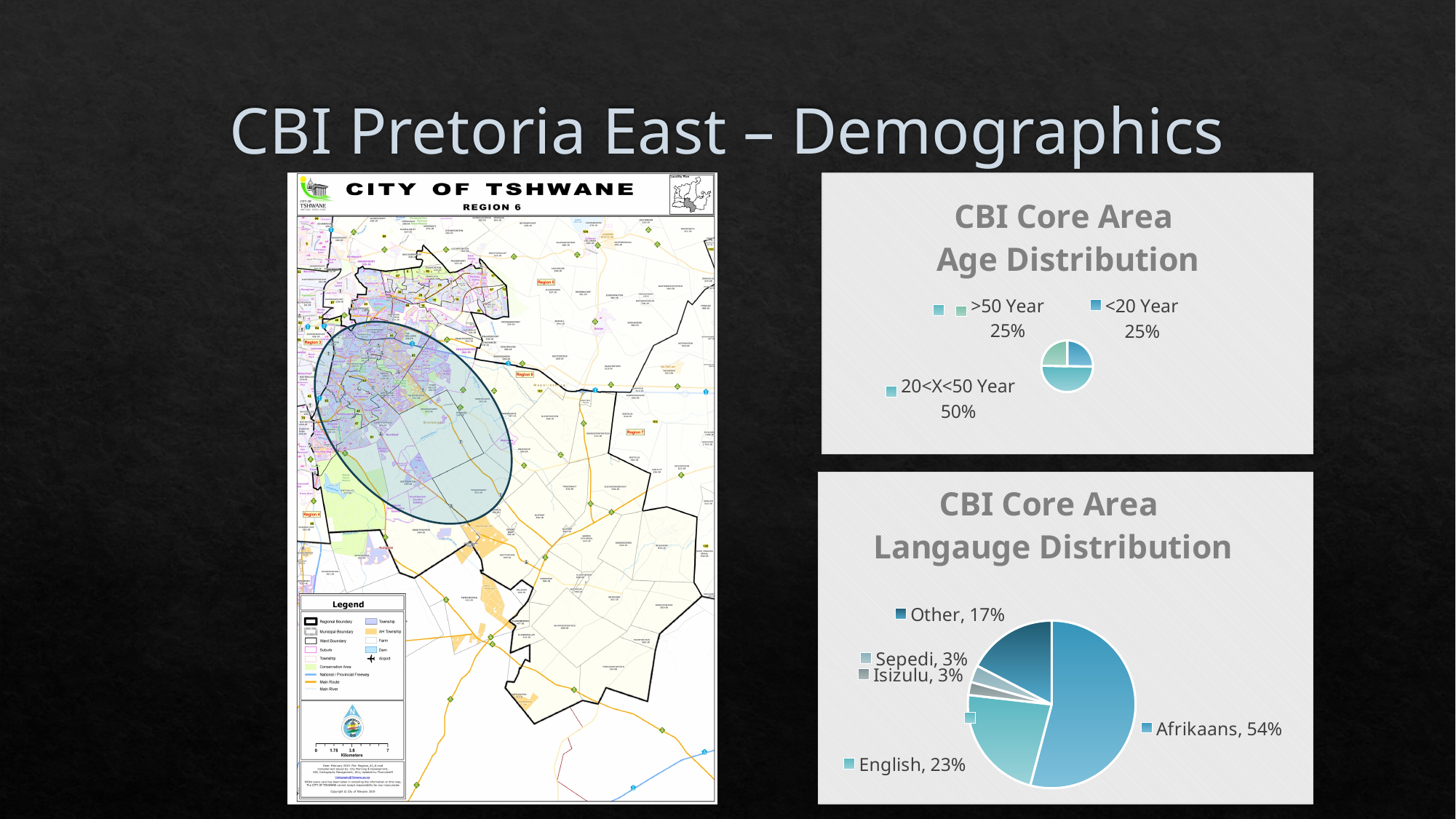
In the CBI Core Area Langauge Distribution chart, what share is English? 23% In the CBI Core Area Langauge Distribution chart, what share is Sepedi? 3% In the CBI Core Area Age Distribution chart, what share is the <20 Year group? 25% In the CBI Core Area Age Distribution chart, what is the difference between the 20<X<50 Year share and the >50 Year share? 25% In the CBI Core Area Langauge Distribution chart, what share is Afrikaans? 54% In the CBI Core Area Langauge Distribution chart, which language has the largest share? Afrikaans In the CBI Core Area Langauge Distribution chart, which is larger, English or Other? English In the CBI Core Area Age Distribution chart, what share is the 20<X<50 Year group? 50% What kind of chart is the CBI Core Area Age Distribution chart? Pie chart In the CBI Core Area Age Distribution chart, which age group has the largest share? 20<X<50 Year In the CBI Core Area Age Distribution chart, how many age groups are shown? 3 In the CBI Core Area Langauge Distribution chart, what is the difference between the Afrikaans share and the English share? 31%